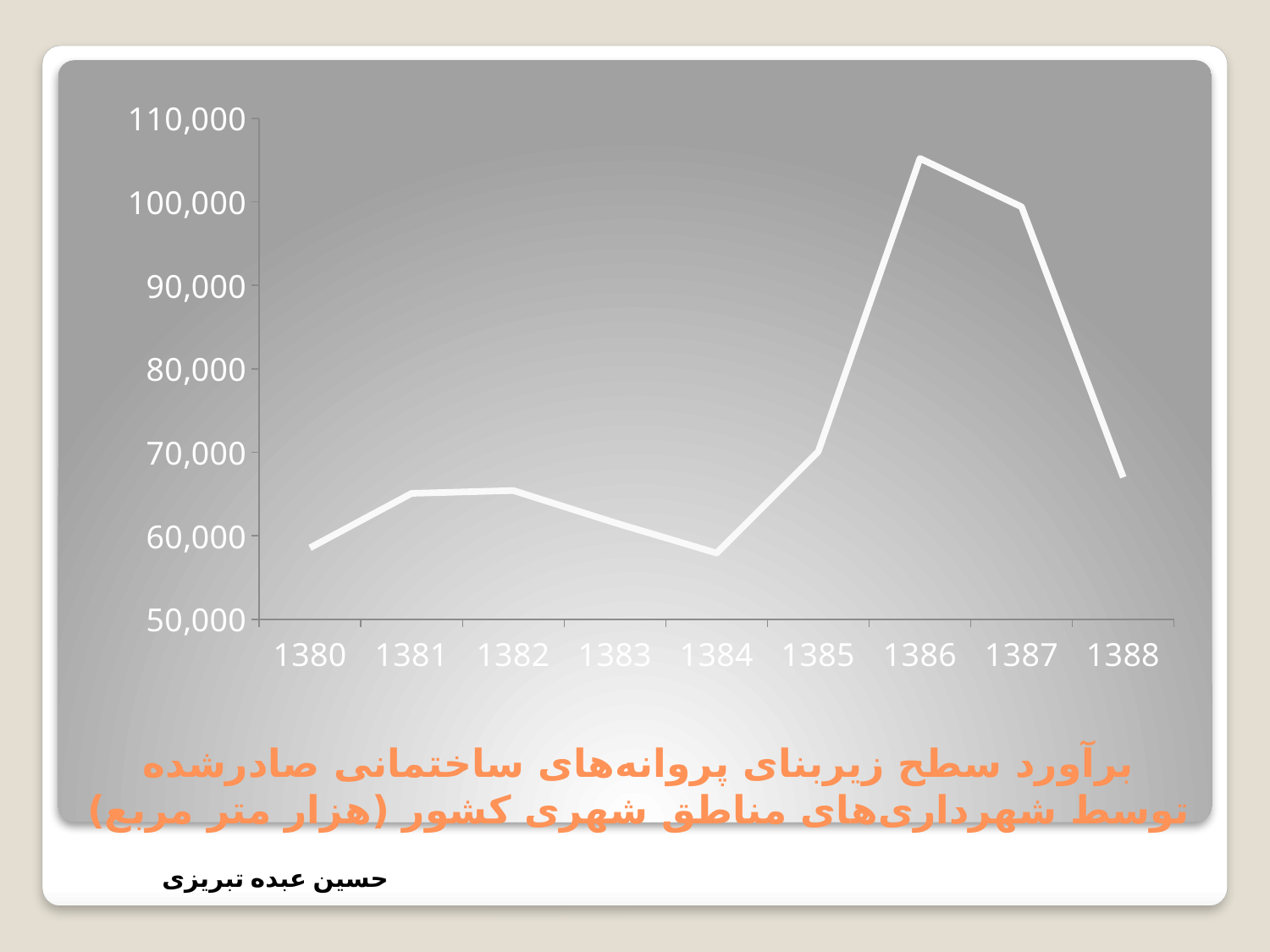
Which is larger, the value for 1386 or the value for 1388? 1386 Does the line rise or fall between 1387 and 1388? fall Is the value for 1387 greater or less than 90,000? greater What is the lowest value shown on the y axis of the chart? 50,000 Is the value for 1386 greater or less than 100,000? greater Which is larger, the value for 1385 or the value for 1384? 1385 Is the value for 1384 greater or less than 60,000? less What kind of chart is shown on the slide? line chart Which year has the highest value on the chart? 1386 How many years are shown on the x axis of the chart? 9